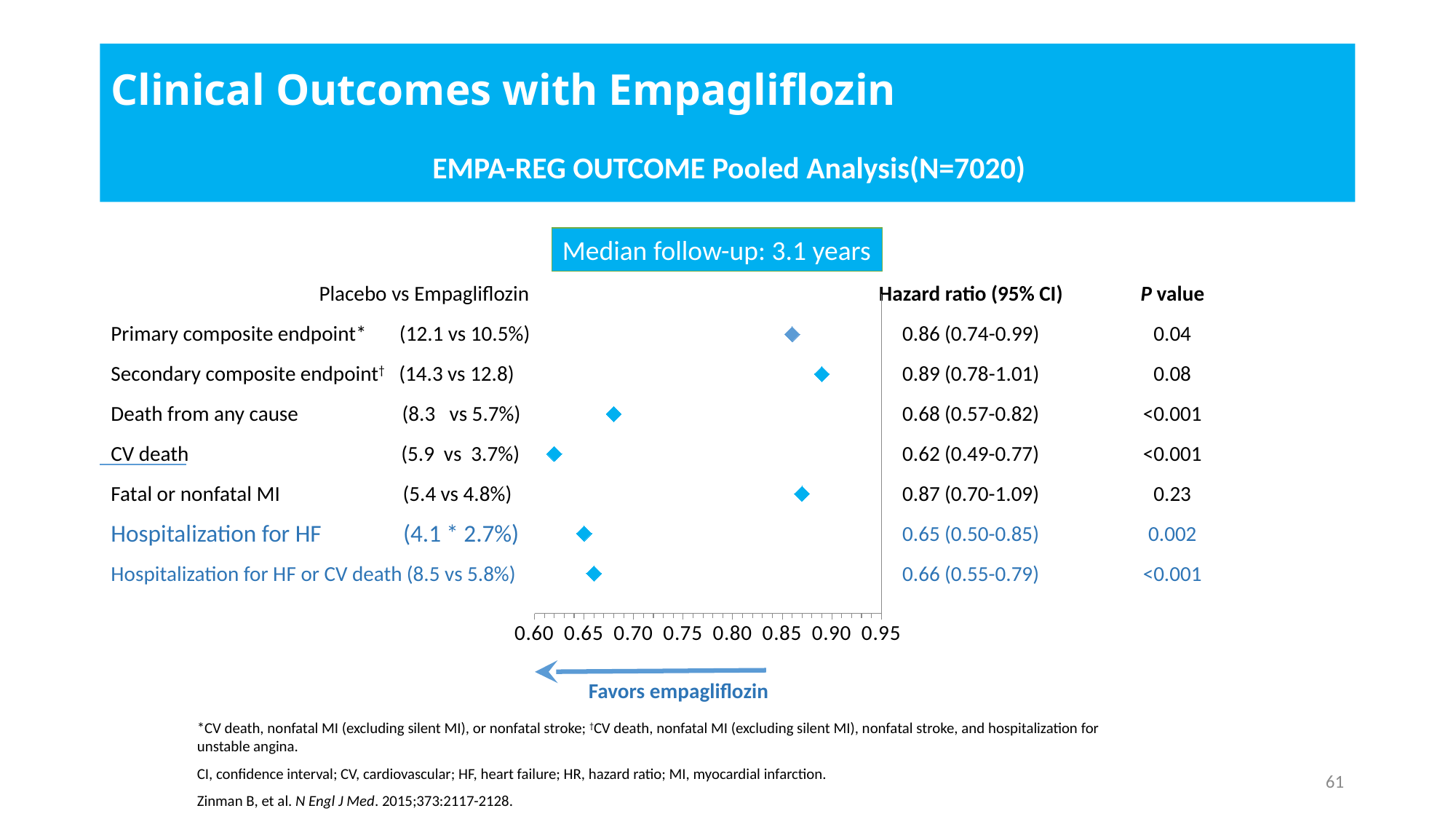
What is the hazard ratio (95% CI) for Hospitalization for HF? 0.65 (0.50-0.85) What is the P value for the Primary composite endpoint? 0.04 What kind of chart is shown on the slide? forest plot Which has a larger hazard ratio, Death from any cause or Fatal or nonfatal MI? Fatal or nonfatal MI How many endpoints are plotted in the chart? 7 What is the hazard ratio for CV death? 0.62 Is the hazard ratio for Fatal or nonfatal MI greater or less than 0.85? greater Is the hazard ratio for Death from any cause greater or less than 0.70? less What is the median follow-up stated above the chart? 3.1 years Which endpoint has the lowest hazard ratio? CV death What is the difference between the hazard ratio for the Secondary composite endpoint and the hazard ratio for CV death? 0.27 Which endpoint has the highest hazard ratio? Secondary composite endpoint